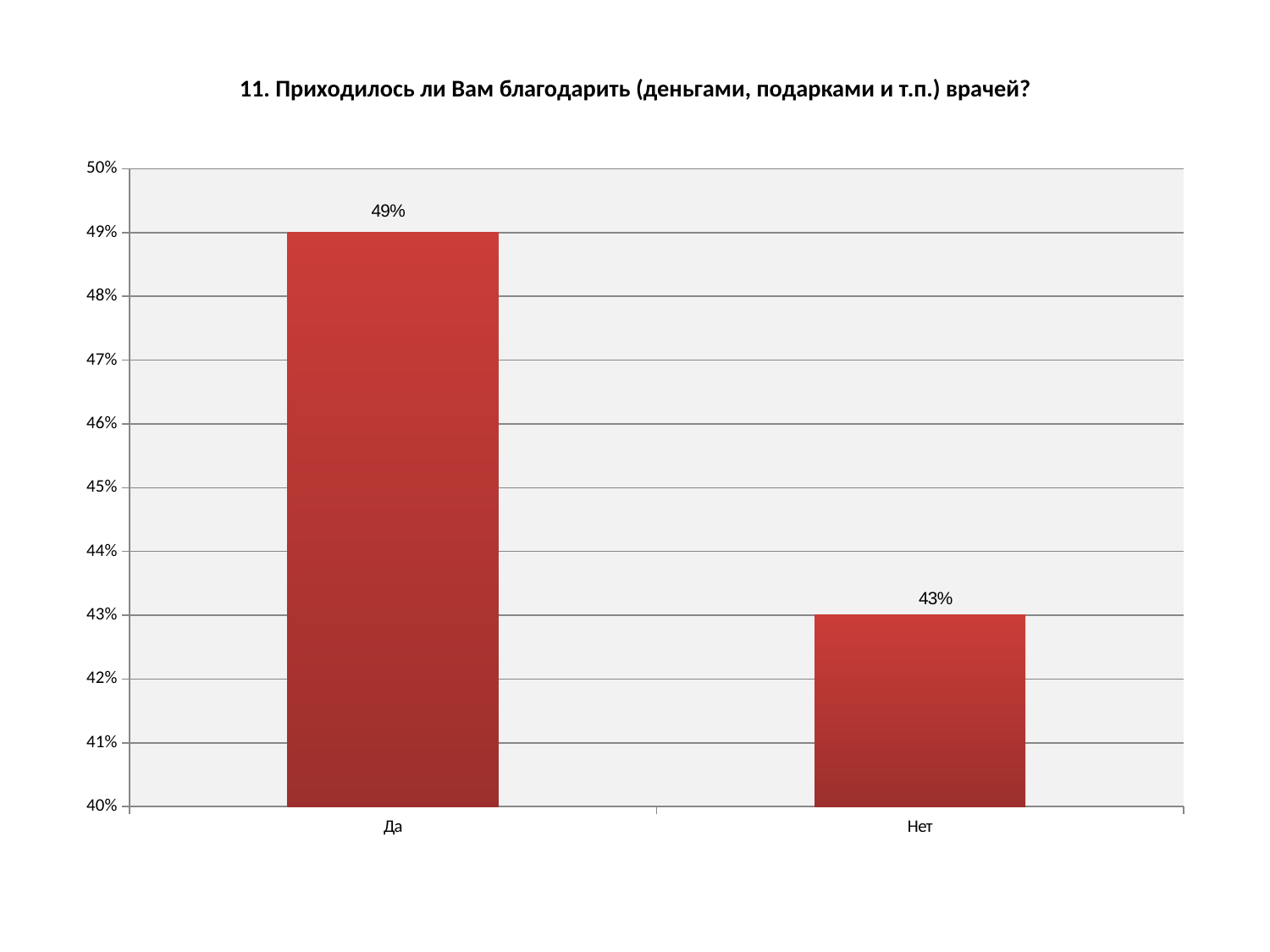
Which category has the lowest value? Нет Is the value for "Да" greater or less than 45%? greater What is the difference between the values for "Да" and "Нет"? 6% How many categories are shown on the x axis? 2 Which is larger, the value for "Да" or the value for "Нет"? Да What kind of chart is shown on the slide? bar chart What is the title of the chart? 11. Приходилось ли Вам благодарить (деньгами, подарками и т.п.) врачей? Which category has the highest value? Да Do the values rise or fall from left to right along the x axis? fall What is the value for "Нет"? 43% What is the value for "Да"? 49% Is the value for "Нет" greater or less than 45%? less